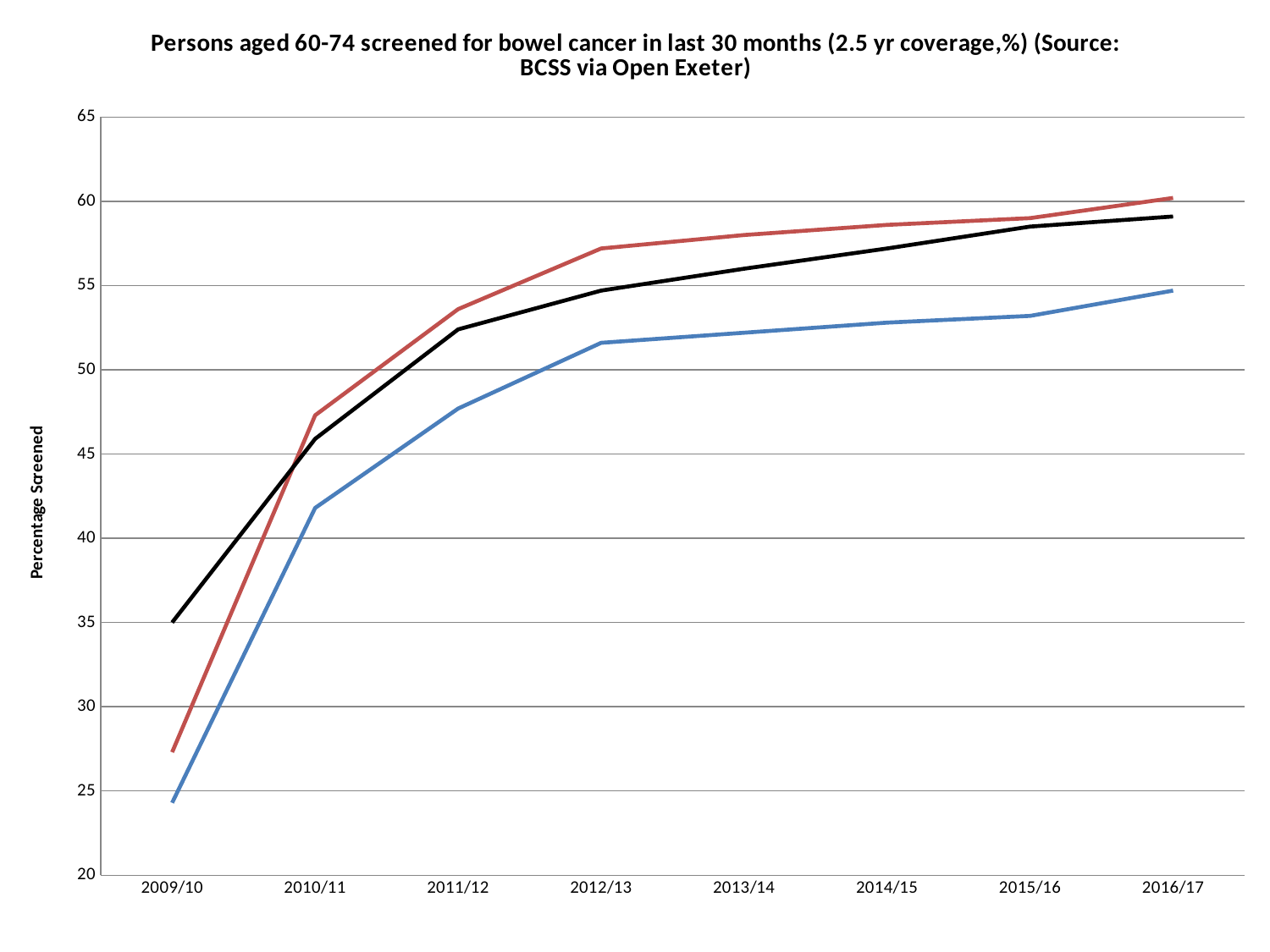
In 2009/10, which is higher: the black line or the red line? the black line Which line has the lowest value in 2009/10? the blue line Is the value of the blue line for 2009/10 greater or less than 25? less Do the values of the blue line rise or fall from 2009/10 to 2016/17? rise How many lines are plotted on the chart? 3 Is the value of the red line for 2012/13 greater or less than 55? greater How many years are shown along the x axis? 8 In 2016/17, which is higher: the red line or the blue line? the red line What kind of chart is shown on the slide? line chart Is the value of the red line for 2009/10 greater or less than 30? less What is the label on the y axis? Percentage Screened